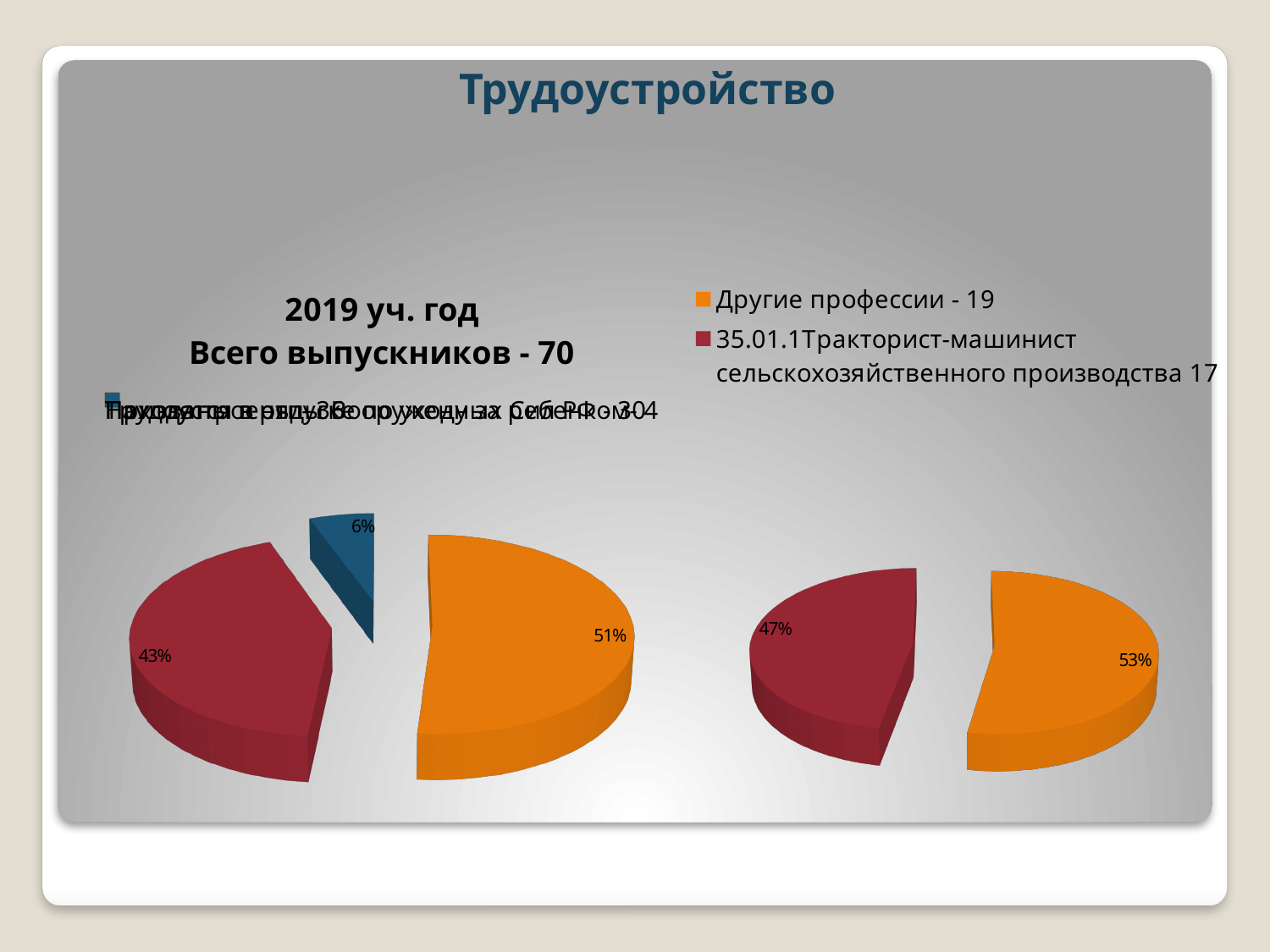
What kind of chart is the right chart on the slide? pie chart In the right chart, what share of the pie is '35.01.1Тракторист-машинист сельскохозяйственного производства 17'? 47% What kind of chart is the left chart titled '2019 уч. год Всего выпускников - 70'? pie chart In the left chart titled '2019 уч. год Всего выпускников - 70', what is the percentage of the largest slice? 51% In the right chart, which category has the larger slice: 'Другие профессии - 19' or '35.01.1Тракторист-машинист сельскохозяйственного производства 17'? Другие профессии - 19 In the right chart, what is the difference in percentage points between the 'Другие профессии - 19' slice and the '35.01.1Тракторист-машинист сельскохозяйственного производства 17' slice? 6 percentage points How many slices does the right chart have? 2 How many slices does the left chart titled '2019 уч. год Всего выпускников - 70' have? 3 In the left chart titled '2019 уч. год Всего выпускников - 70', what is the percentage of the smallest slice? 6% How many entries does the legend of the right chart list? 2 In the right chart, what share of the pie is 'Другие профессии - 19'? 53% What is the title of the left chart? 2019 уч. год Всего выпускников - 70